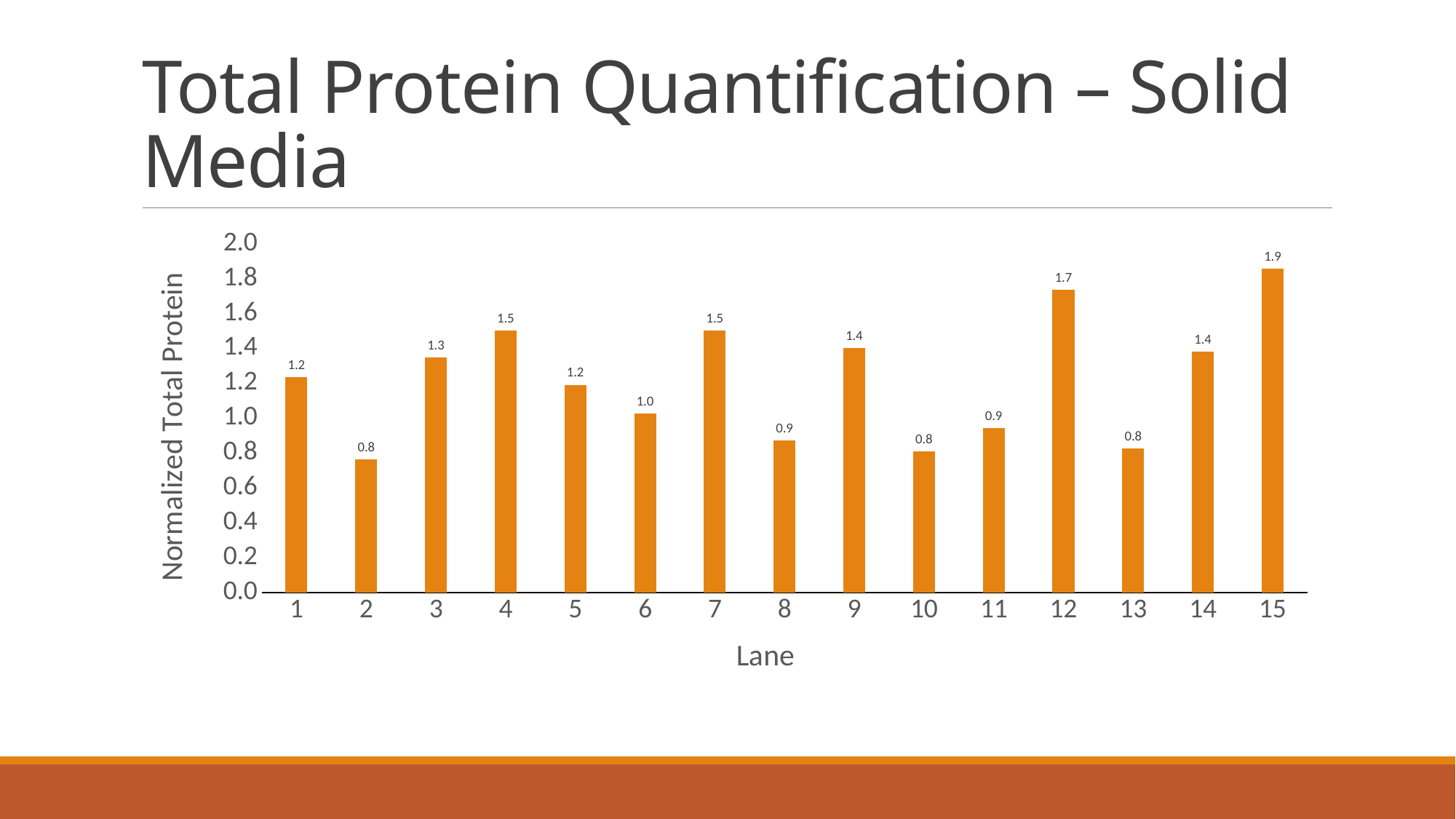
Is the value for lane 10 greater or less than 1.0? less Which lane has the highest normalized total protein? 15 How many lanes are shown on the x axis? 15 What is the normalized total protein value for lane 12? 1.7 What is the normalized total protein value for lane 6? 1.0 What is the normalized total protein value for lane 3? 1.3 What is the label of the y axis? Normalized Total Protein Is the value for lane 12 greater or less than 1.6? greater What is the difference between the values for lane 15 and lane 2? 1.1 What is the label of the x axis? Lane What kind of chart is shown on the slide? Bar chart Which has a larger value, lane 4 or lane 8? Lane 4